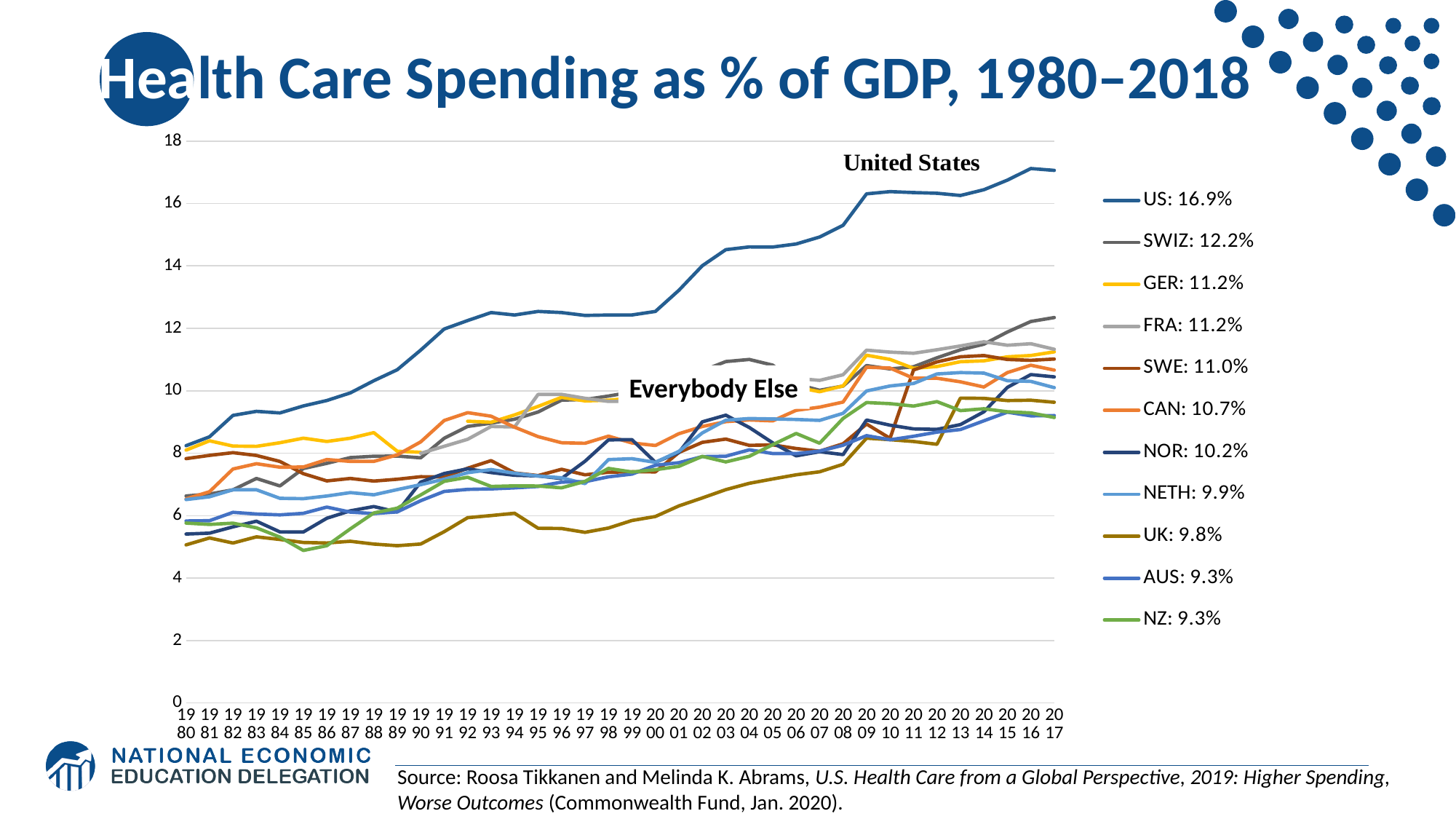
How many series does the legend list? 11 Which has the larger legend value, GER or SWE? GER What kind of chart is shown on the slide? line chart According to the legend, what is the value shown for SWIZ? 12.2% According to the legend, what is the value shown for UK? 9.8% Is the value for the UK line in 1985 greater or less than 6? less Which country has the highest value in the legend? US Is the value for the US line in 2017 greater or less than 16? greater What is the title of the chart? Health Care Spending as % of GDP, 1980–2018 What is the difference between the legend values for US and SWIZ? 4.7 percentage points Does the US line rise or fall from 1980 to 2017? rise According to the legend, what is the value shown for US? 16.9%